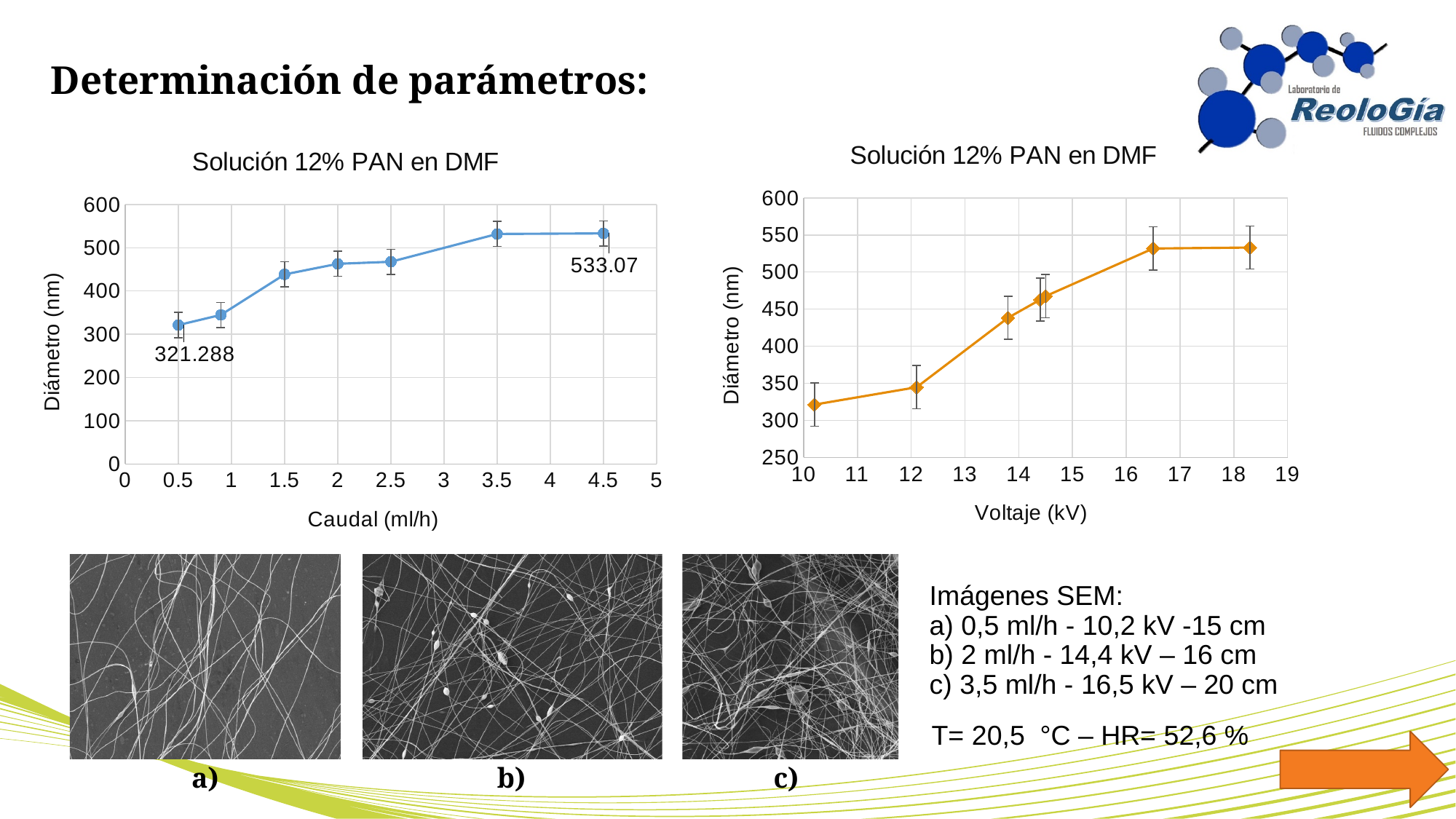
What kind of chart is the right chart (x axis Voltaje)? Line chart In the right chart (x axis Voltaje), is the value at about 12 kV greater or less than 400? less In the left chart (x axis Caudal), what is the diameter value labelled at 4.5 ml/h? 533.07 In the left chart (x axis Caudal), do the diameter values rise or fall as the flow rate increases? Rise In the left chart (x axis Caudal), at which flow rate is the diameter lowest? 0.5 ml/h How many data points are plotted in the left chart (x axis Caudal)? 7 In the left chart (x axis Caudal), what is the diameter value labelled at 0.5 ml/h? 321.288 In the left chart (x axis Caudal), is the value at 1.5 ml/h greater or less than 400? greater What is the x-axis label of the right chart? Voltaje (kV) In the right chart (x axis Voltaje), do the diameter values rise or fall as the voltage increases? Rise In the left chart (x axis Caudal), what is the difference between the labelled values at 4.5 ml/h and 0.5 ml/h? 211.782 What kind of chart is the left chart (x axis Caudal)? Line chart